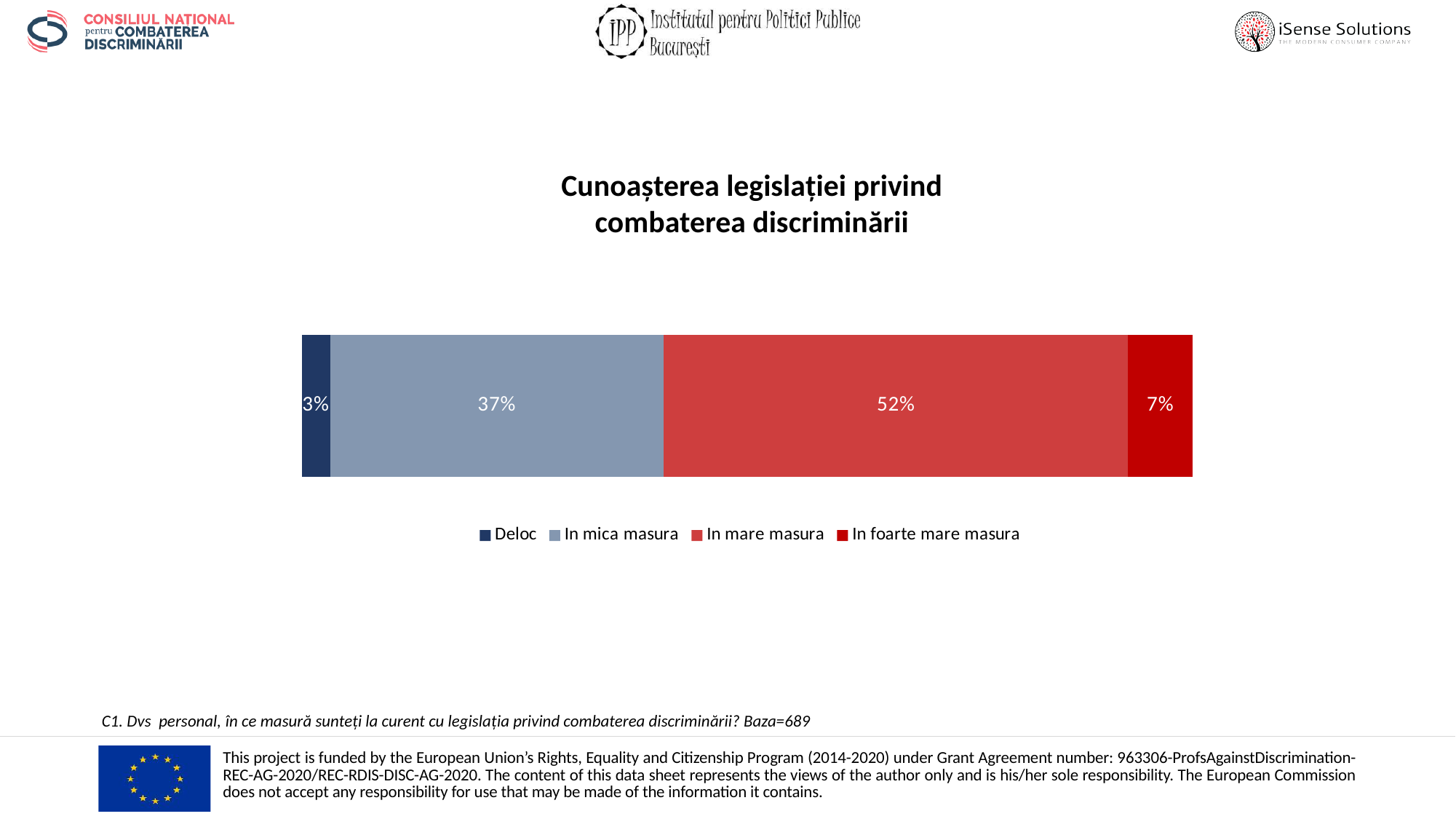
What percentage of respondents answered "In foarte mare masura"? 7% What is the title of the chart? Cunoașterea legislației privind combaterea discriminării What percentage of respondents answered "Deloc"? 3% Which is larger, the share for "In foarte mare masura" or the share for "Deloc"? In foarte mare masura What is the total of all segments in the stacked bar? 99% What kind of chart is shown on the slide? Stacked bar chart What percentage of respondents answered "In mica masura"? 37% How many series does the legend list? 4 Which response category has the largest share? In mare masura What is the difference in percentage points between "In mare masura" and "In mica masura"? 15 What percentage of respondents answered "In mare masura"? 52% Which response category has the smallest share? Deloc